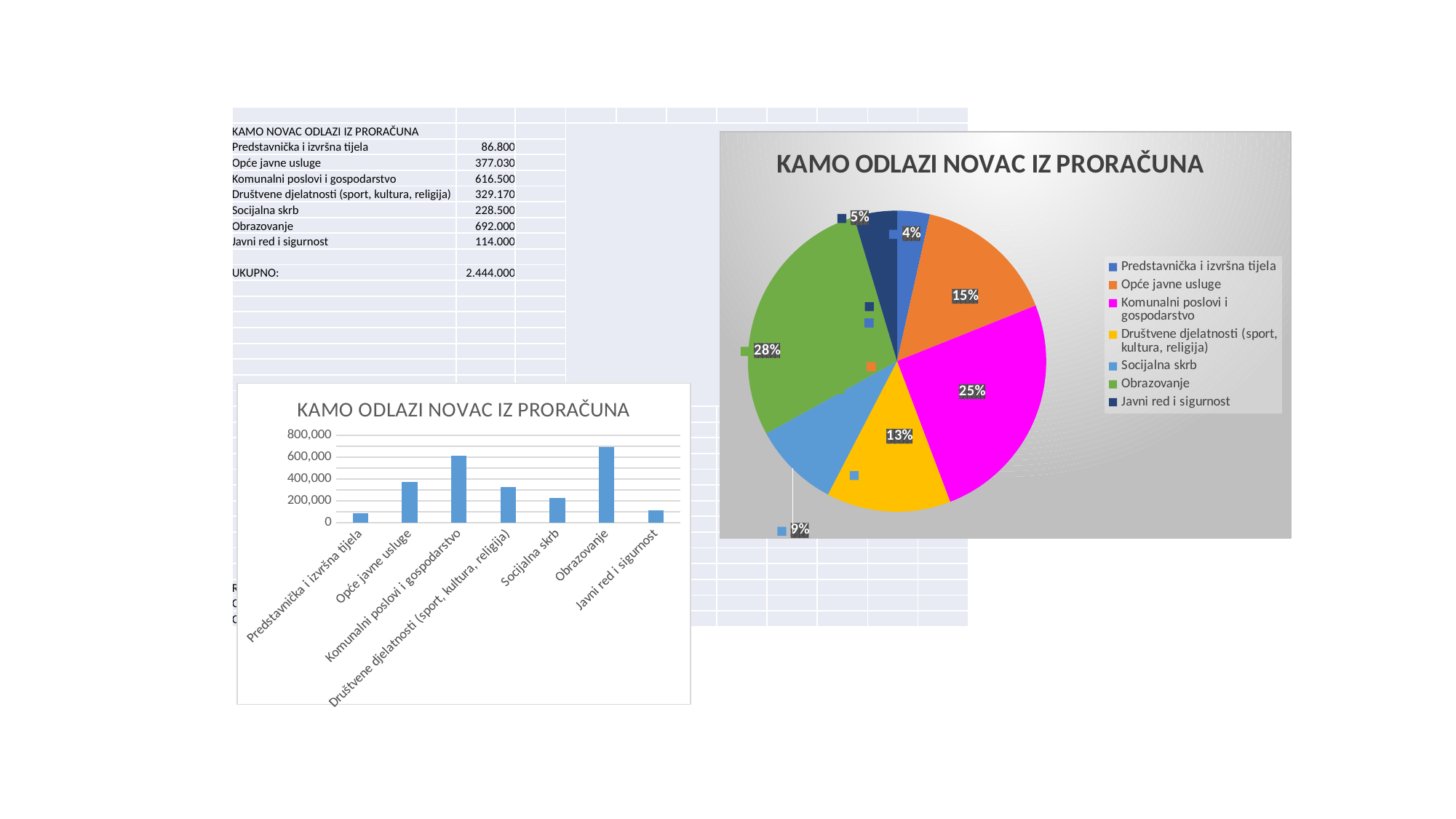
In the pie chart on the right, which category has the largest slice? Obrazovanje In the bar chart in the bottom left, is the value for Obrazovanje greater or less than 600,000? greater In the pie chart on the right, how many percentage points larger is the Obrazovanje share than the Opće javne usluge share? 13 percentage points In the pie chart on the right, what percentage is labelled for Socijalna skrb? 9% In the bar chart in the bottom left, is the value for Javni red i sigurnost greater or less than 200,000? less In the bar chart in the bottom left, which is larger: Opće javne usluge or Socijalna skrb? Opće javne usluge How many categories does the legend of the pie chart on the right list? 7 In the pie chart on the right, what share of the budget goes to Obrazovanje? 28% How many categories are shown on the x axis of the bar chart in the bottom left? 7 What kind of chart is the chart in the bottom left of the slide? Bar chart In the pie chart on the right, which category has the smallest slice? Predstavnička i izvršna tijela In the pie chart on the right, what share is shown for Komunalni poslovi i gospodarstvo? 25%